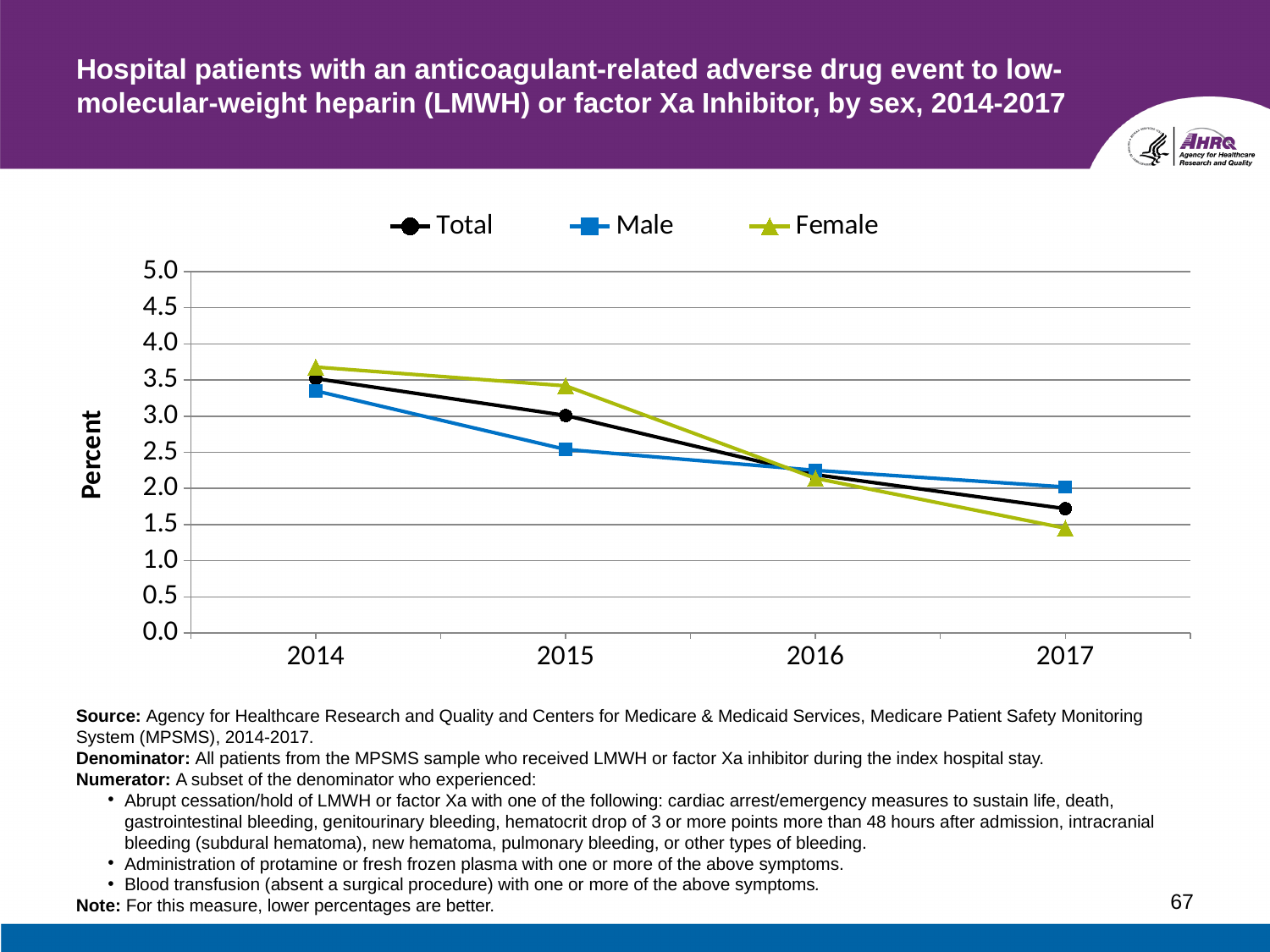
In 2017, which is higher, Male or Female? Male Is the value for Female in 2014 greater or less than 3.5? greater Is the value for Female in 2017 greater or less than 2.0? less Is the value for Male in 2015 greater or less than 3.0? less What is the label on the y axis? Percent In 2015, which is higher, Male or Female? Female Which series has the lowest value in 2017? Female How many years are plotted along the x axis? 4 Does the Total series rise or fall from 2014 to 2017? fall What kind of chart is shown on the slide? line chart How many series does the legend list? 3